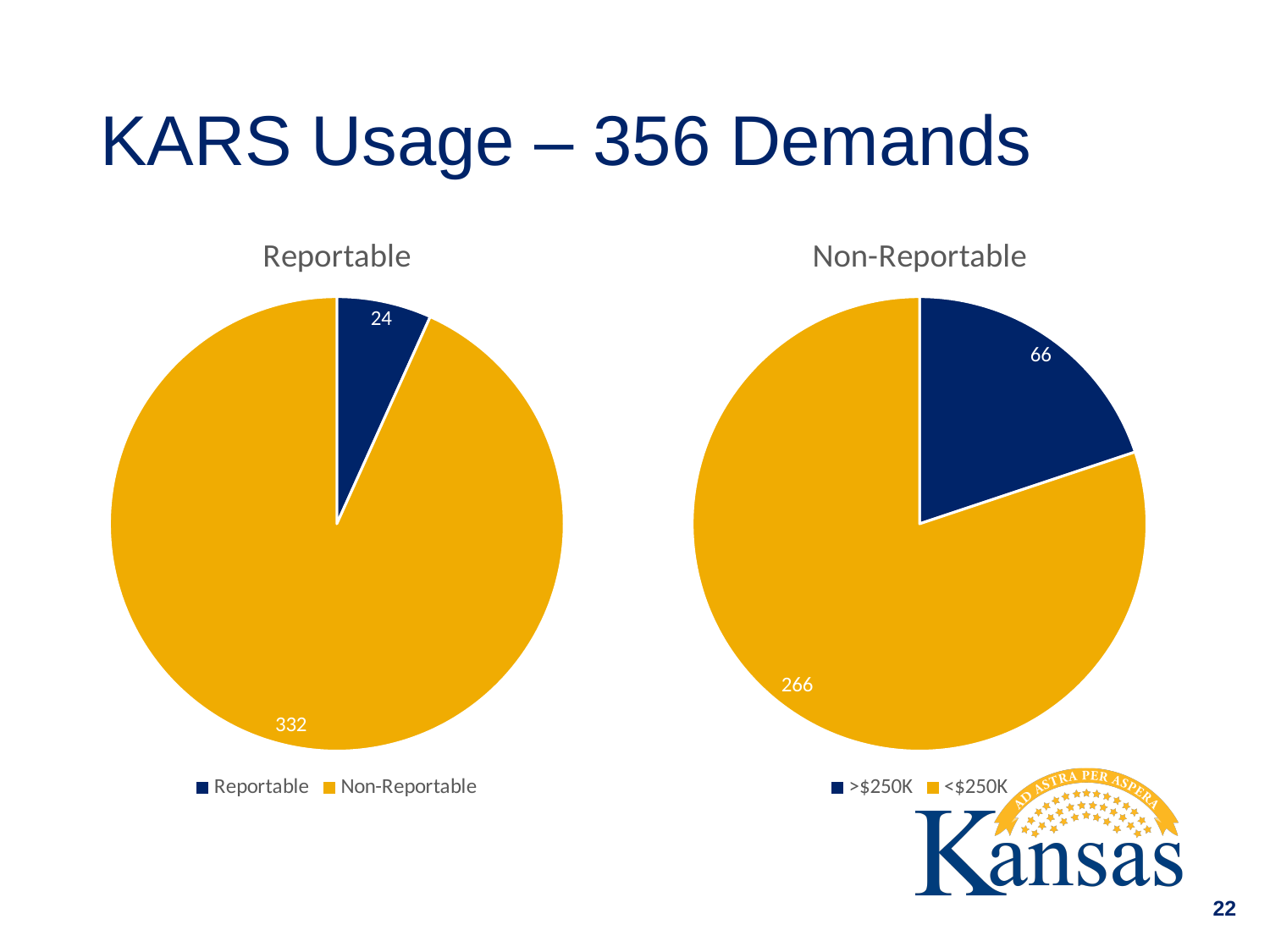
In the "Reportable" pie chart, what is the difference between the Non-Reportable and Reportable values? 308 In the "Non-Reportable" pie chart, what is the difference between the <$250K and >$250K values? 200 In the "Non-Reportable" pie chart, what is the value for the <$250K slice? 266 In the "Non-Reportable" pie chart, what is the value for the >$250K slice? 66 In the "Reportable" pie chart, what is the value for the Non-Reportable slice? 332 In the "Non-Reportable" pie chart, which slice is the smallest? >$250K In the "Reportable" pie chart, which slice is the largest? Non-Reportable In the "Reportable" pie chart, what is the value for the Reportable slice? 24 What type of chart is used on the left of the slide? Pie chart In the "Non-Reportable" pie chart, which is larger, >$250K or <$250K? <$250K In the "Non-Reportable" pie chart, what share of the total does the >$250K slice represent, to the nearest whole percent? 20% How many slices does the "Non-Reportable" pie chart have? 2